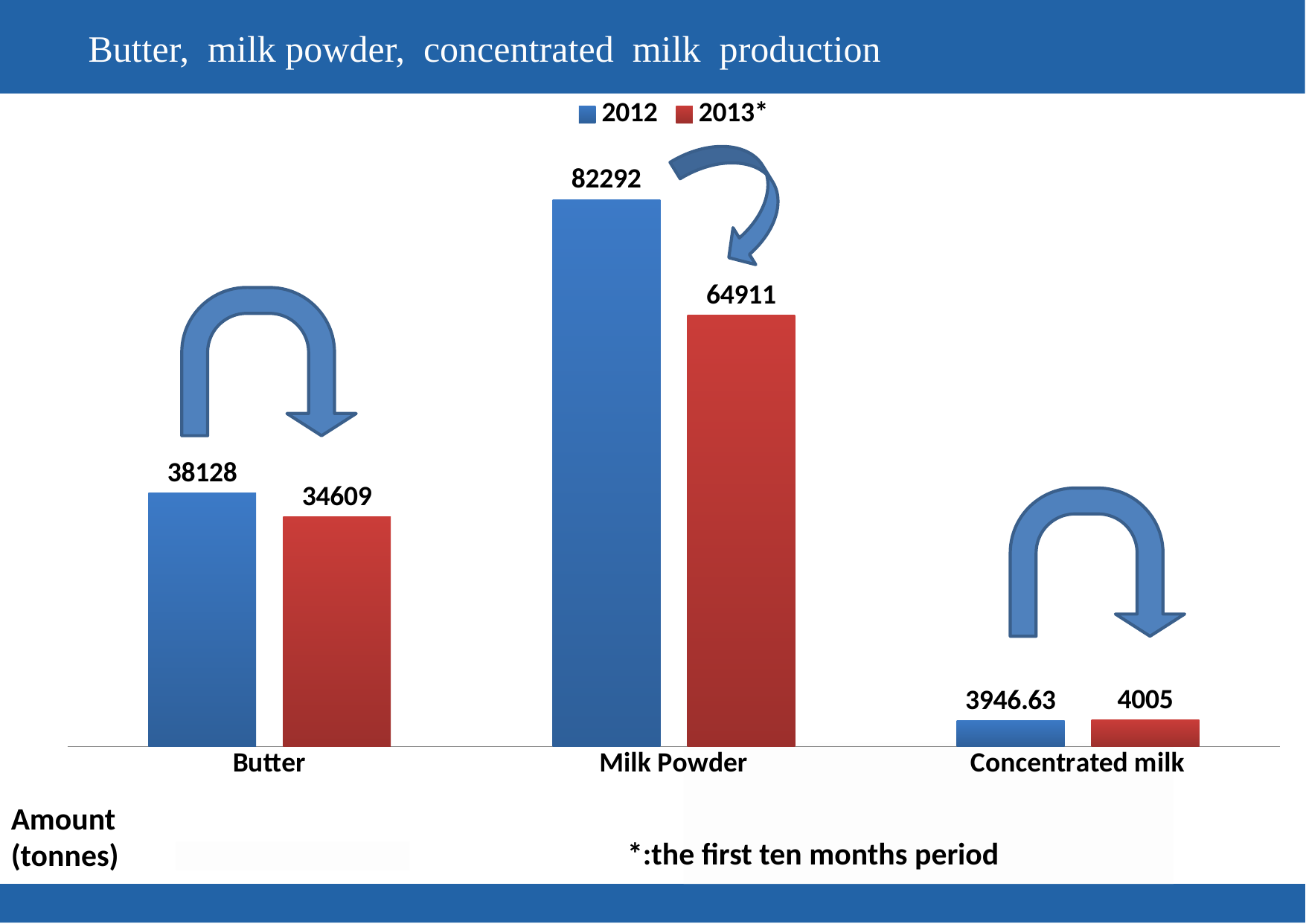
What was the concentrated milk production in 2013*? 4005 Which product had the highest production in 2012? Milk Powder What was the butter production in 2012? 38128 What type of chart is shown on the slide? Bar chart How many series does the legend list? 2 How many product categories are shown on the x axis? 3 What was the milk powder production in 2013*? 64911 Which product had the lowest production in 2013*? Concentrated milk What is the difference between butter production in 2012 and 2013*? 3519 Which year had higher butter production, 2012 or 2013*? 2012 What is the difference between milk powder production in 2012 and 2013*? 17381 What was the concentrated milk production in 2012? 3946.63